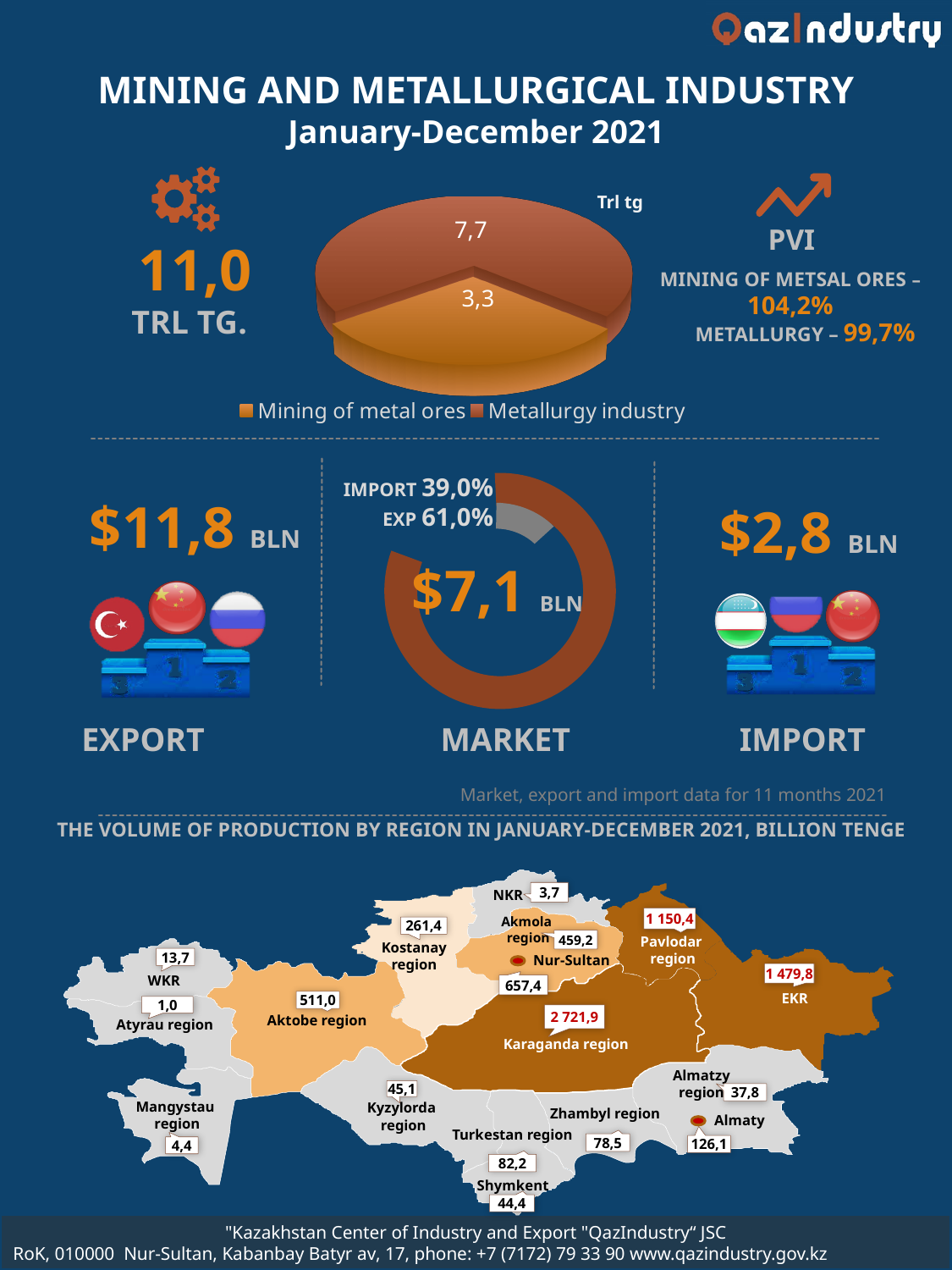
In the pie chart at the top of the slide, which slice is larger: Mining of metal ores or Metallurgy industry? Metallurgy industry In the pie chart at the top of the slide, what unit is indicated next to the chart? Trl tg In the MARKET donut chart in the middle of the slide, what share is shown for EXP? 61,0% In the pie chart at the top of the slide, what value is shown for the Metallurgy industry slice? 7,7 In the pie chart at the top of the slide, what is the difference between the Metallurgy industry value and the Mining of metal ores value? 4,4 In the MARKET donut chart in the middle of the slide, which segment is larger: IMPORT or EXP? EXP In the pie chart at the top of the slide, what value is shown for the Mining of metal ores slice? 3,3 How many entries does the legend of the pie chart at the top of the slide list? 2 In the MARKET donut chart in the middle of the slide, what share is shown for IMPORT? 39,0% In the MARKET donut chart in the middle of the slide, what total value is printed in the centre? $7,1 BLN On the regional production map at the bottom of the slide, which region has the highest value? Karaganda region What type of chart is used at the top of the slide to show the split between Mining of metal ores and Metallurgy industry? Pie chart